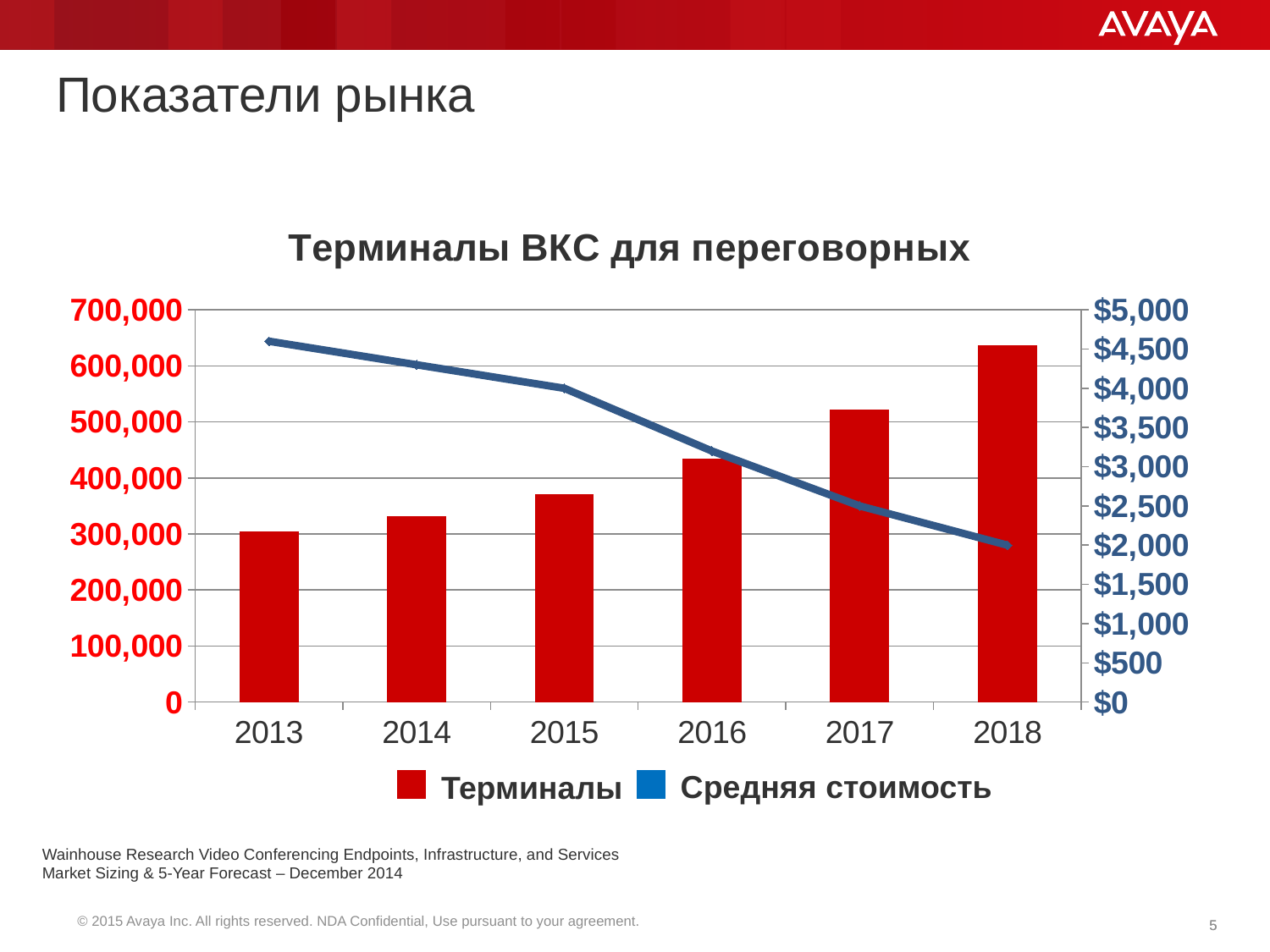
Is the value for Терминалы in 2015 greater or less than 400,000? less Is the Средняя стоимость in 2013 greater or less than $4,000? greater Does the Средняя стоимость line rise or fall from 2013 to 2018? Fall Which is larger, the Терминалы value for 2017 or for 2014? 2017 Is the value for Терминалы in 2018 greater or less than 600,000? greater What is the title of the chart? Терминалы ВКС для переговорных Do the Терминалы bars rise or fall from 2013 to 2018? Rise Which year has the lowest value for Терминалы? 2013 How many series does the legend list? 2 What kind of chart is shown on the slide? A combined bar and line chart How many years are shown on the x axis of the chart? 6 Which year has the highest value for Терминалы? 2018